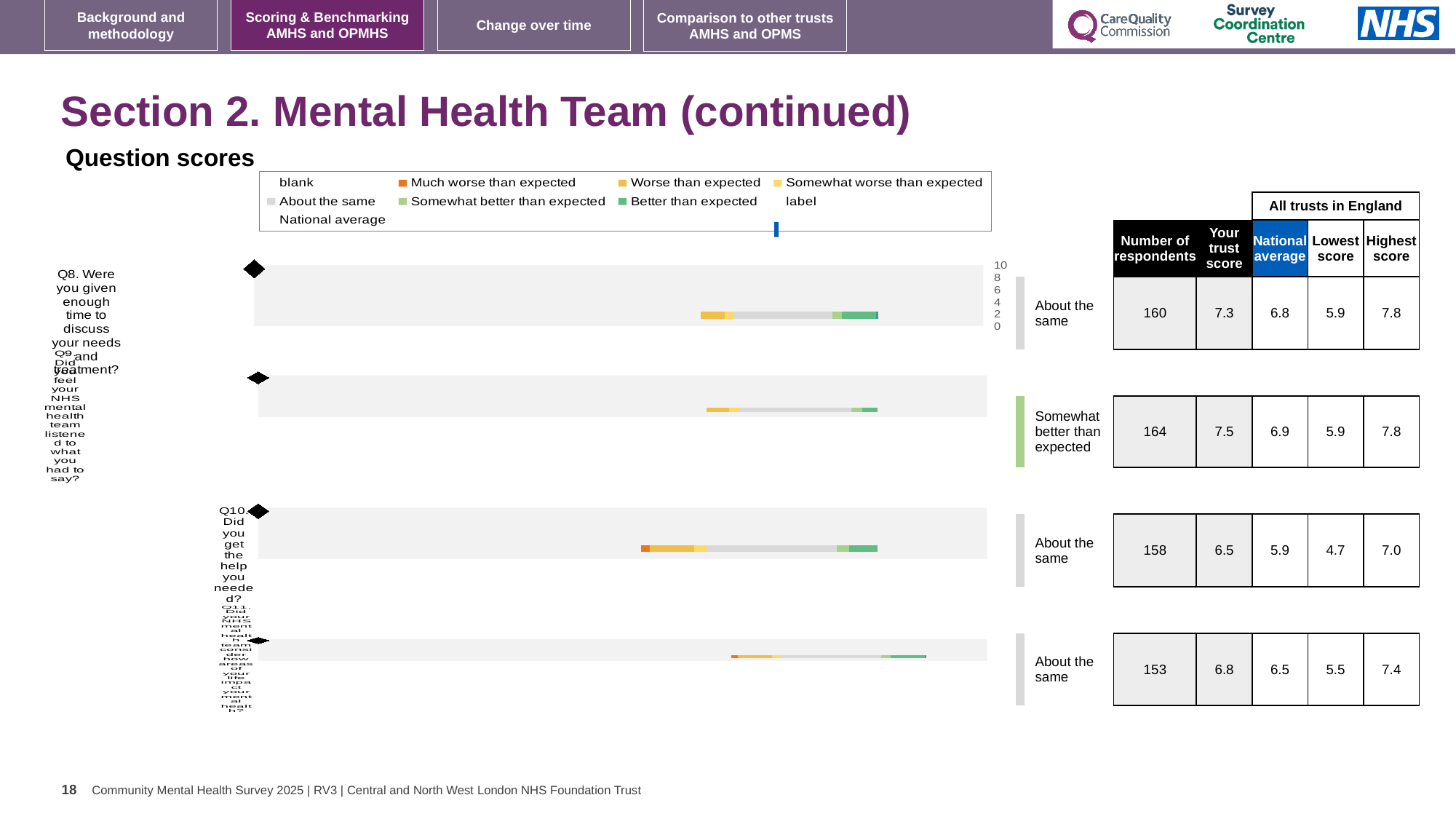
What colour represents 'Better than expected' in the legend? green How many question charts (Q8 to Q11) are shown on the slide? 4 What kind of chart is used to show the question scores for Q8 to Q11? bar chart Which question's chart is labelled 'Somewhat better than expected'? Q9 Which question has the lowest 'Your trust score' in the tables? Q10 Which question has the highest 'Your trust score' in the tables? Q9 For Q9, which is larger: 'Your trust score' or the National average? Your trust score For Q8, what is the difference between 'Your trust score' and the National average? 0.5 In the table beside the Q8 chart, what is 'Your trust score'? 7.3 In the table beside the Q11 chart, what is the Number of respondents? 153 In the table beside the Q10 chart, what is the National average? 5.9 In the table beside the Q10 chart, what is the Lowest score among all trusts in England? 4.7